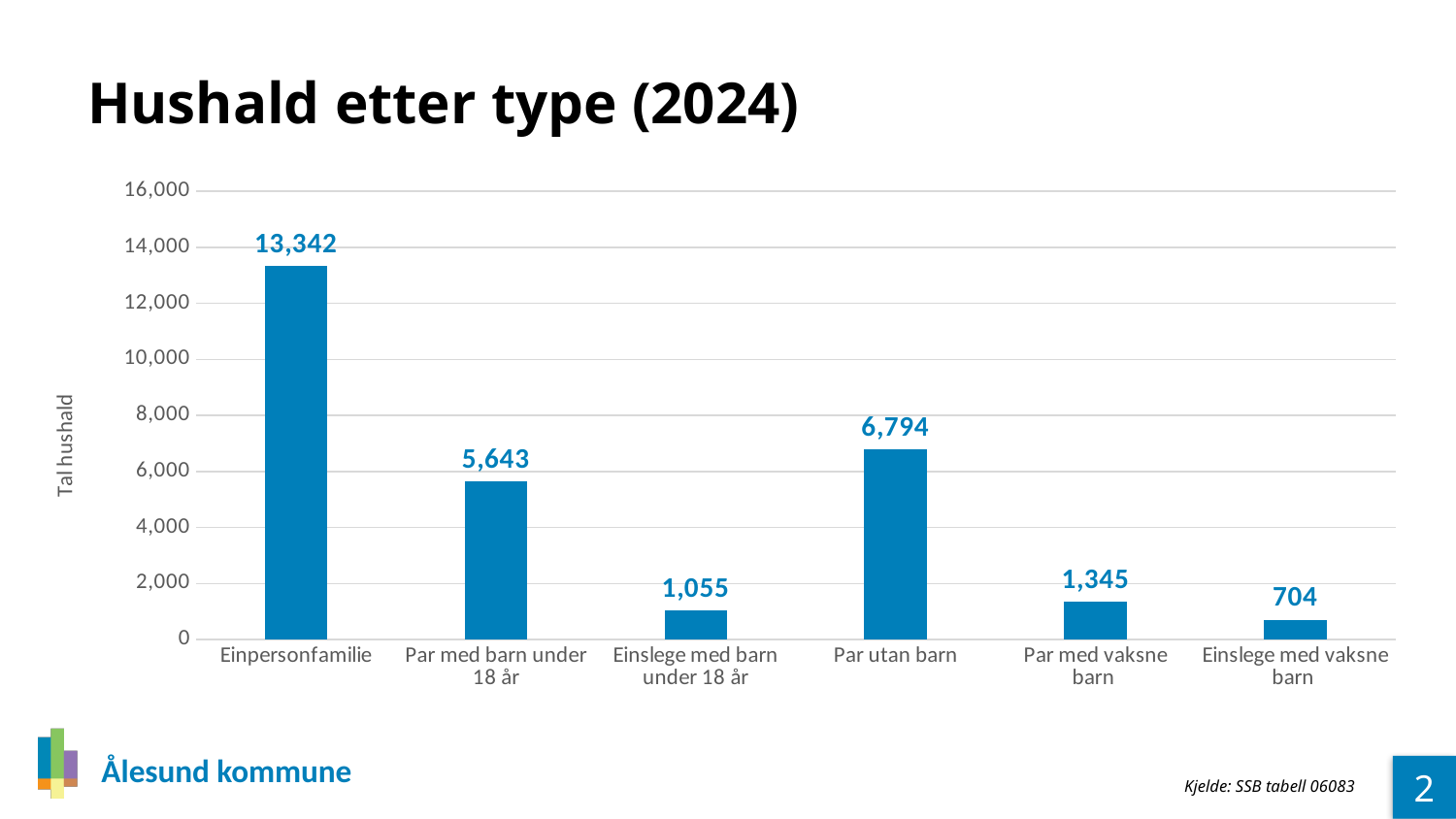
What kind of chart is shown on the slide? bar chart What is the title of the chart? Hushald etter type (2024) Which is larger, Par med vaksne barn or Einslege med barn under 18 år? Par med vaksne barn What is the value for Par utan barn? 6,794 How many household types are shown on the chart? 6 What is the difference between Par utan barn and Par med barn under 18 år? 1,151 What is the value for Einpersonfamilie? 13,342 What is the value for Einslege med vaksne barn? 704 Which household type has the lowest value? Einslege med vaksne barn What is the label of the vertical axis? Tal hushald Which household type has the highest value? Einpersonfamilie Is the value for Par med barn under 18 år greater or less than 6,000? less